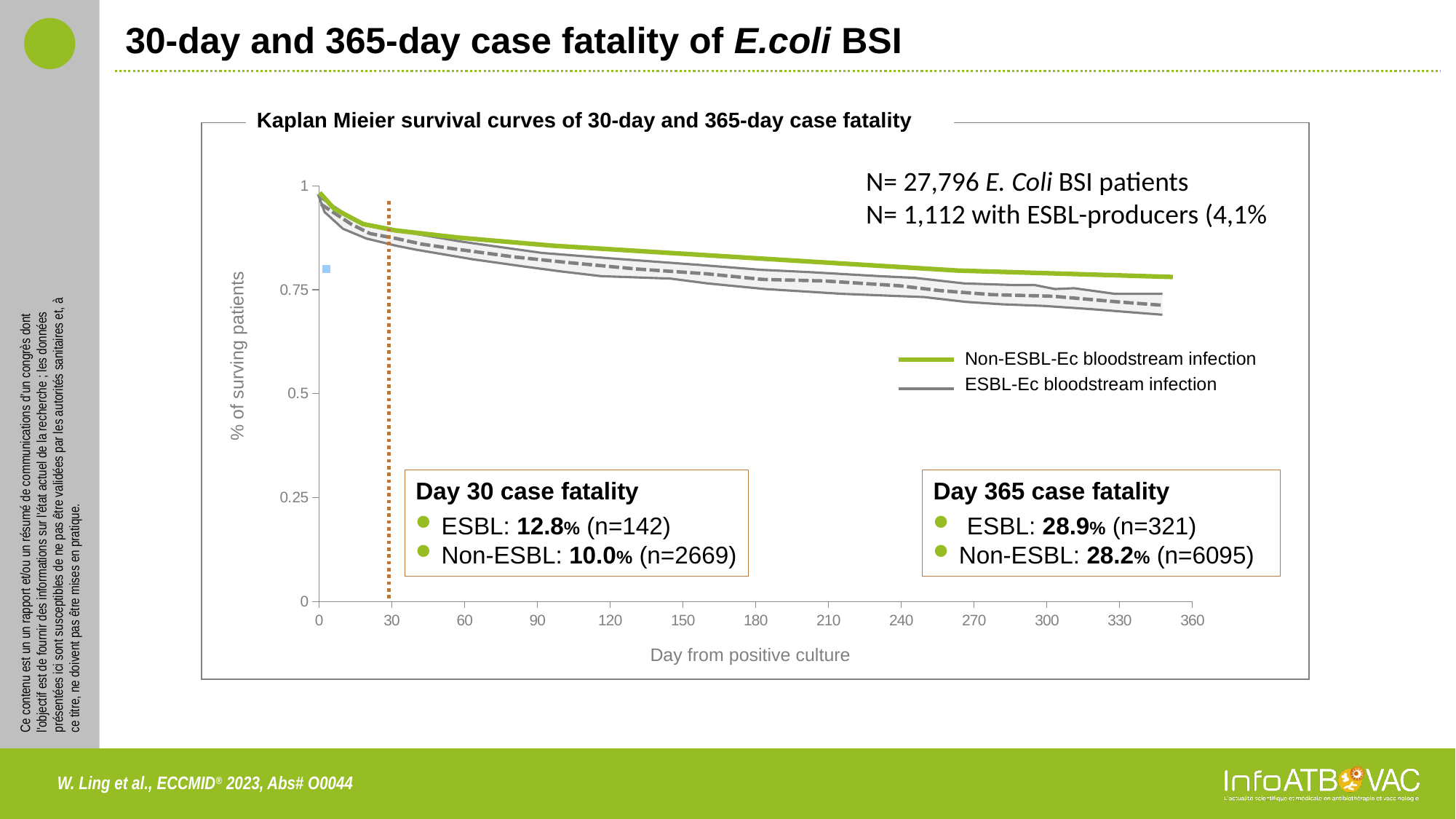
Is the proportion of surviving patients for the Non-ESBL-Ec curve at day 30 greater or less than 0.75? greater Which group has the higher Day 365 case fatality, ESBL or Non-ESBL? ESBL What is the difference between the Day 30 case fatality of ESBL and Non-ESBL patients? 2.8 percentage points What is the Day 30 case fatality for ESBL patients? 12.8% (n=142) What is the Day 30 case fatality for Non-ESBL patients? 10.0% (n=2669) What is the Day 365 case fatality for ESBL patients? 28.9% (n=321) What is the Day 365 case fatality for Non-ESBL patients? 28.2% (n=6095) How many series does the chart legend list? 2 Do the survival curves rise or fall as the days from positive culture increase? Fall What type of chart is shown on the slide? Line chart (Kaplan-Meier survival curves) Which curve lies higher at day 180, Non-ESBL-Ec or ESBL-Ec bloodstream infection? Non-ESBL-Ec bloodstream infection What is the title of the chart? Kaplan Mieier survival curves of 30-day and 365-day case fatality